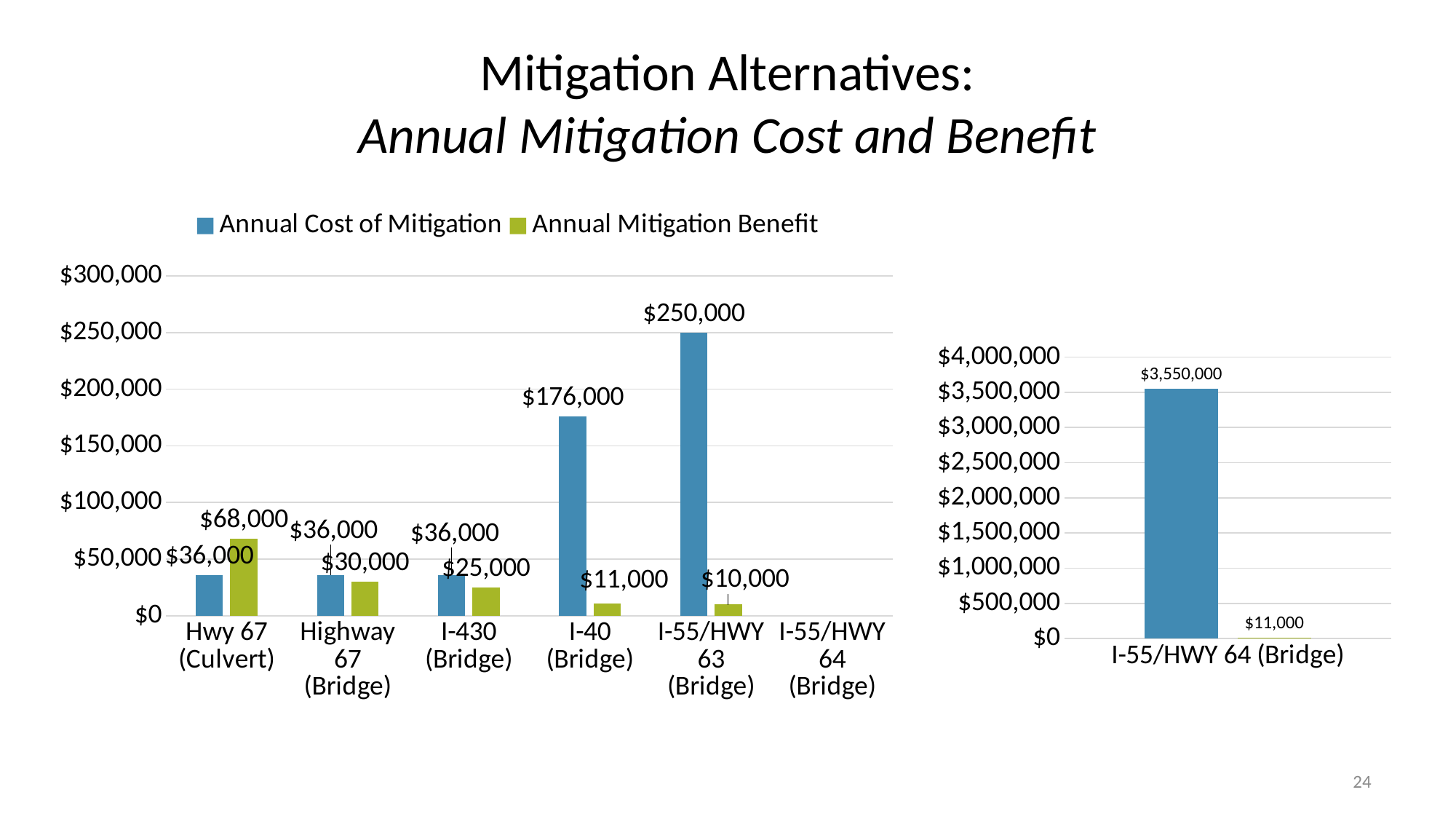
In the right chart, what is the Annual Mitigation Benefit for I-55/HWY 64 (Bridge)? $11,000 In the left chart, which category has the highest Annual Mitigation Benefit? Hwy 67 (Culvert) In the left chart, what is the Annual Cost of Mitigation for I-40 (Bridge)? $176,000 In the left chart, which is larger for Hwy 67 (Culvert): the Annual Cost of Mitigation or the Annual Mitigation Benefit? Annual Mitigation Benefit How many series does the legend of the left chart list? 2 In the left chart, what is the Annual Mitigation Benefit for I-55/HWY 63 (Bridge)? $10,000 In the left chart, is the Annual Cost of Mitigation for I-55/HWY 63 (Bridge) greater or less than $200,000? greater In the left chart, which category has the highest Annual Cost of Mitigation? I-55/HWY 63 (Bridge) In the right chart, what is the Annual Cost of Mitigation for I-55/HWY 64 (Bridge)? $3,550,000 In the left chart, what is the Annual Mitigation Benefit for Hwy 67 (Culvert)? $68,000 What kind of chart is the chart on the right? Bar chart In the left chart, what is the difference between the Annual Cost of Mitigation and the Annual Mitigation Benefit for I-40 (Bridge)? $165,000